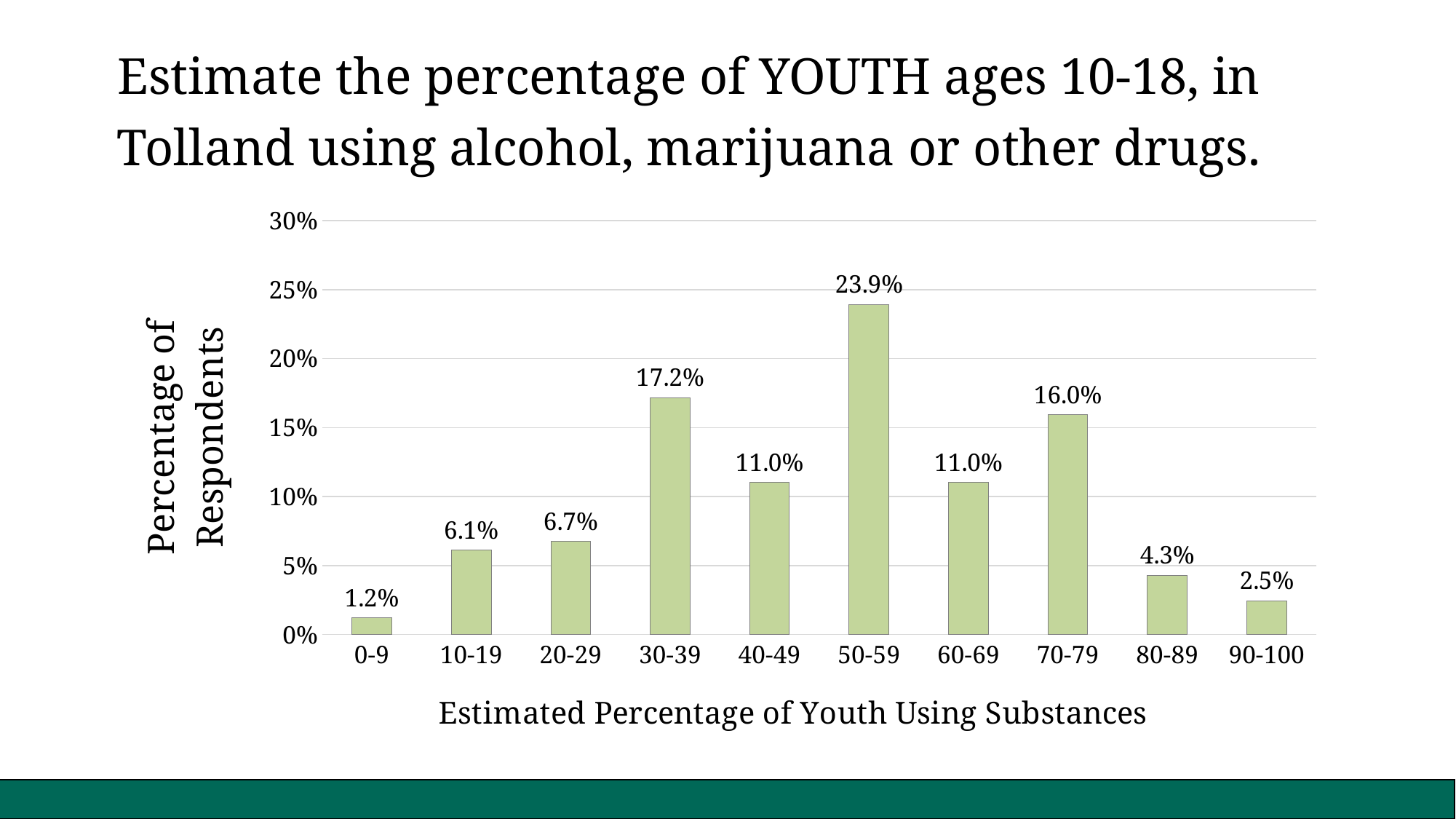
What kind of chart is shown on the slide? bar chart What percentage of respondents estimated 0-9? 1.2% What is the label of the y axis? Percentage of Respondents Which estimate range has the lowest percentage of respondents? 0-9 Which has a larger percentage of respondents, 10-19 or 20-29? 20-29 How many estimate ranges are shown on the x axis? 10 What is the label of the x axis? Estimated Percentage of Youth Using Substances Is the value for 30-39 greater or less than 15%? greater What is the difference in percentage of respondents between the 50-59 and 30-39 ranges? 6.7% What percentage of respondents estimated 70-79? 16.0% What percentage of respondents estimated 50-59? 23.9% Which estimate range has the highest percentage of respondents? 50-59